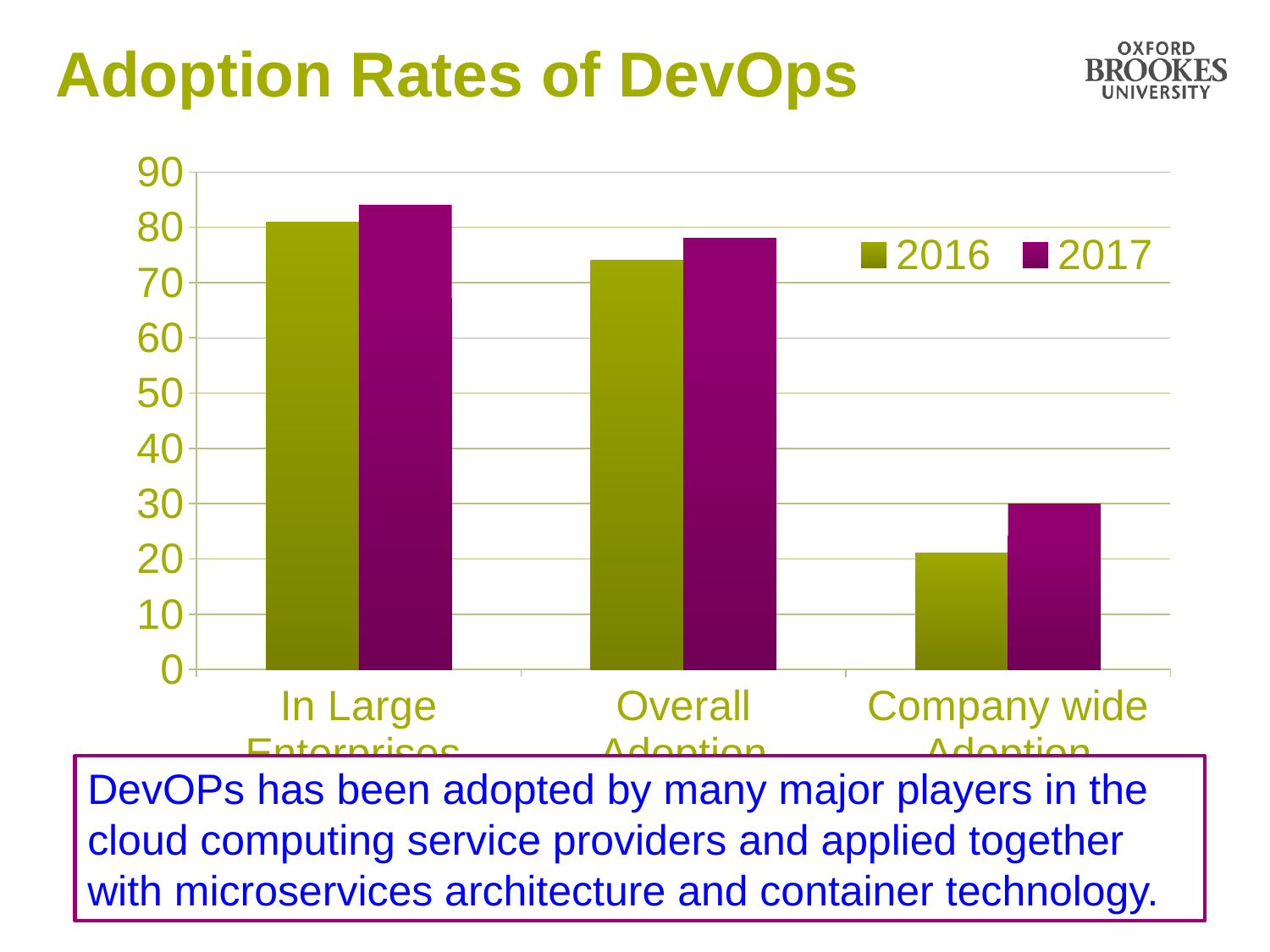
What kind of chart is shown on the slide? bar chart Which is larger: the 2016 value for Overall Adoption or the 2016 value for In Large Enterprises? In Large Enterprises Which category has the lowest 2016 value? Company wide Adoption Which category has the highest 2017 value? In Large Enterprises Is the 2016 value for Company wide Adoption greater or less than 30? less What is the title of the slide containing the chart? Adoption Rates of DevOps How many series does the legend list? 2 Is the 2017 value for In Large Enterprises greater or less than 80? greater For Company wide Adoption, which series has the larger value, 2016 or 2017? 2017 Is the 2017 value for Overall Adoption greater or less than 80? less How many categories are shown on the x axis? 3